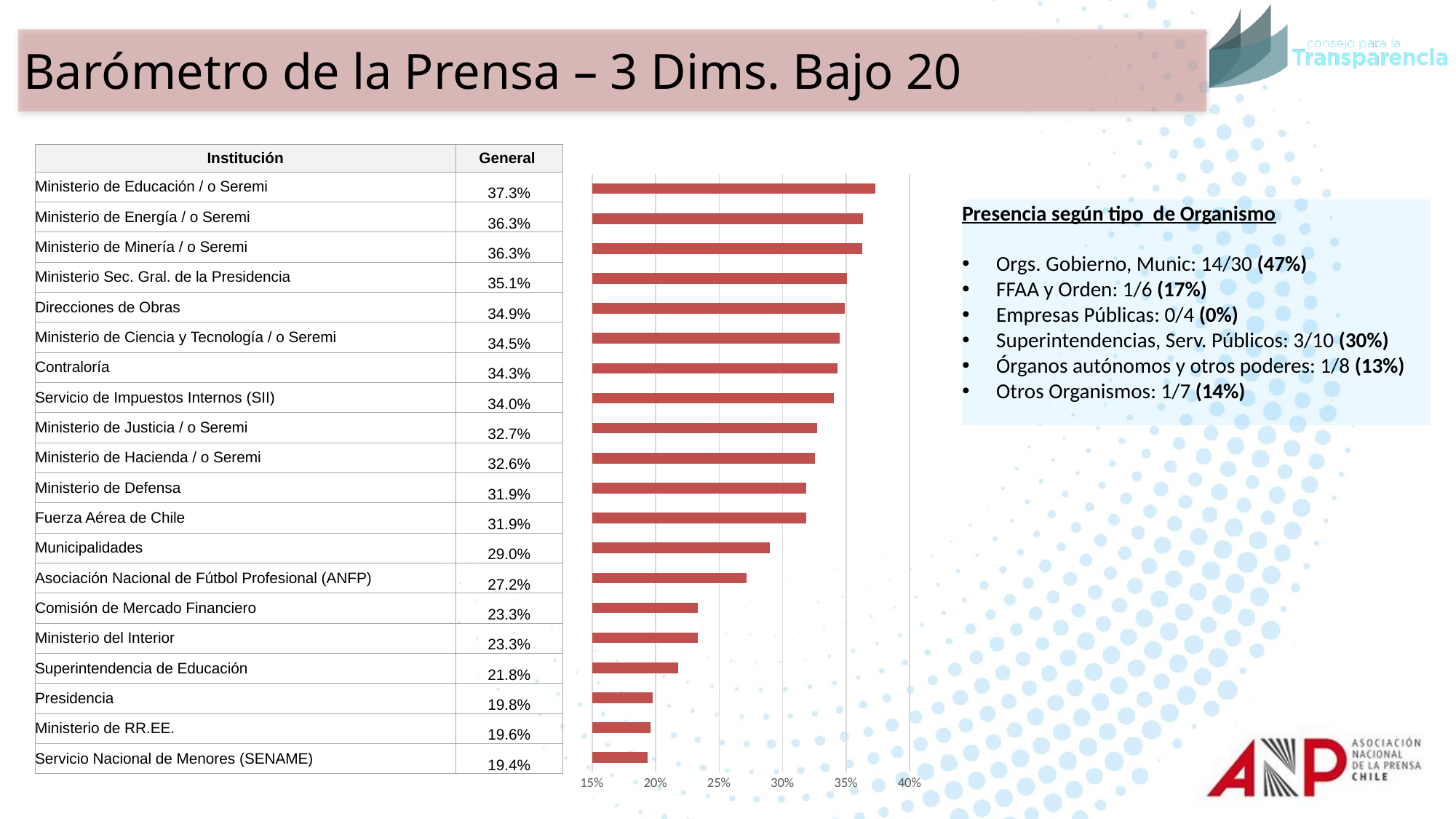
Which institution has the lowest value in the chart (the last bar, listed last in the table)? Servicio Nacional de Menores (SENAME) What type of chart is shown on the slide? Bar chart What is the difference between the value for Ministerio de Educación / o Seremi and the value for Servicio Nacional de Menores (SENAME)? 17.9 percentage points What is the General value for Contraloría? 34.3% Which institution has the highest value in the chart (the longest bar, listed first in the table)? Ministerio de Educación / o Seremi What is the difference between the value for Municipalidades and the value for Asociación Nacional de Fútbol Profesional (ANFP)? 1.8 percentage points Which has a larger value, Municipalidades or Asociación Nacional de Fútbol Profesional (ANFP)? Municipalidades Is the value for Superintendencia de Educación greater or less than 25%? less Do the bar lengths increase or decrease going from the top of the chart to the bottom? Decrease How many bars does the chart contain? 20 What is the General value for Municipalidades? 29.0% What are the minimum and maximum values shown on the chart's horizontal axis? 15% and 40%